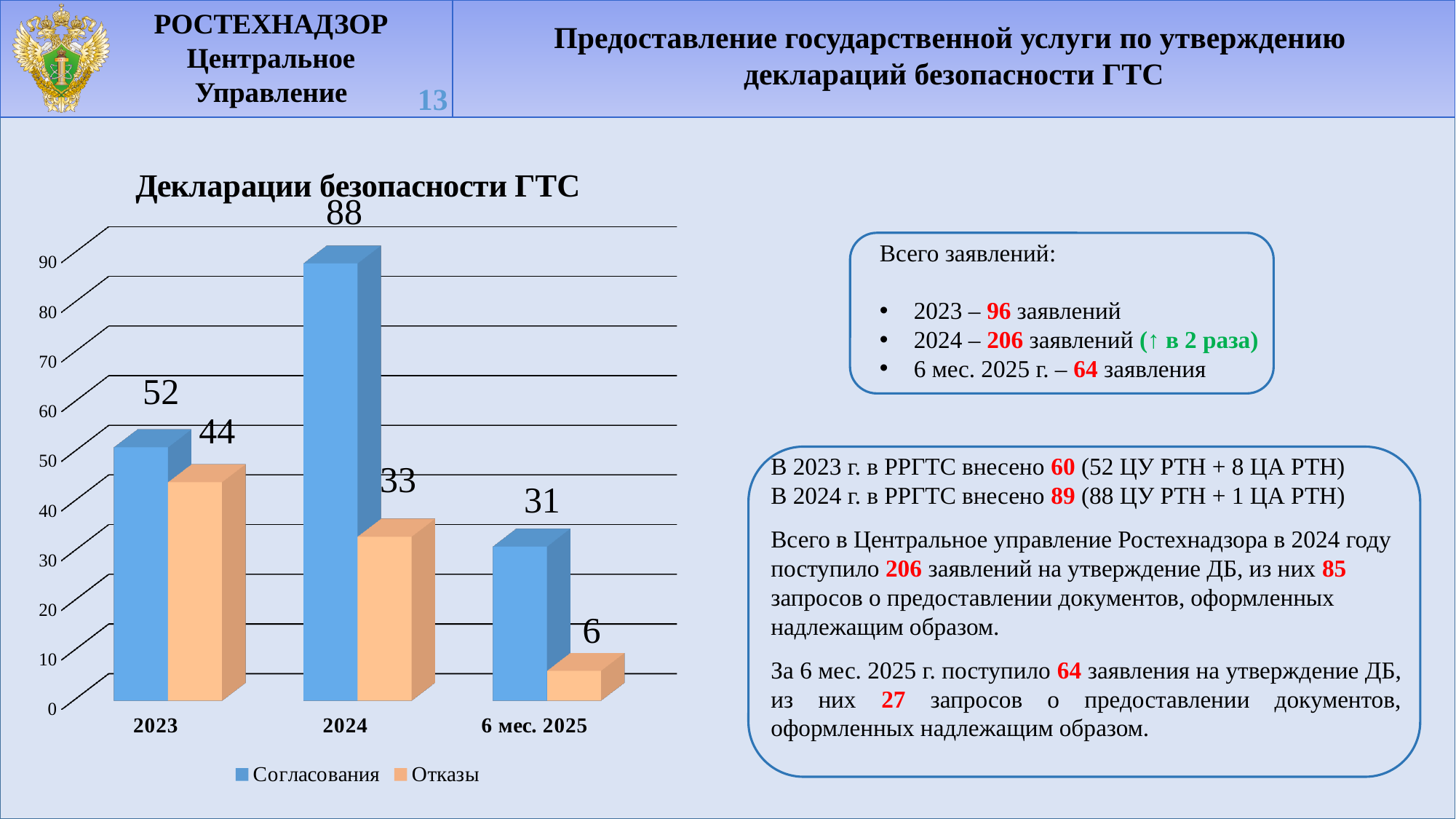
What kind of chart is shown? bar chart What is the difference between Согласования and Отказы in 2024? 55 Which category has the lowest value for Отказы? 6 мес. 2025 Is the value for Согласования in 6 мес. 2025 greater or less than 40? less How many series does the legend list? 2 How many categories are shown on the x axis? 3 What is the title of the chart? Декларации безопасности ГТС What is the value for Отказы in 6 мес. 2025? 6 What is the value for Отказы in 2023? 44 Which category has the highest value for Согласования? 2024 What is the value for Согласования in 2024? 88 Which is larger in 2023: Согласования or Отказы? Согласования